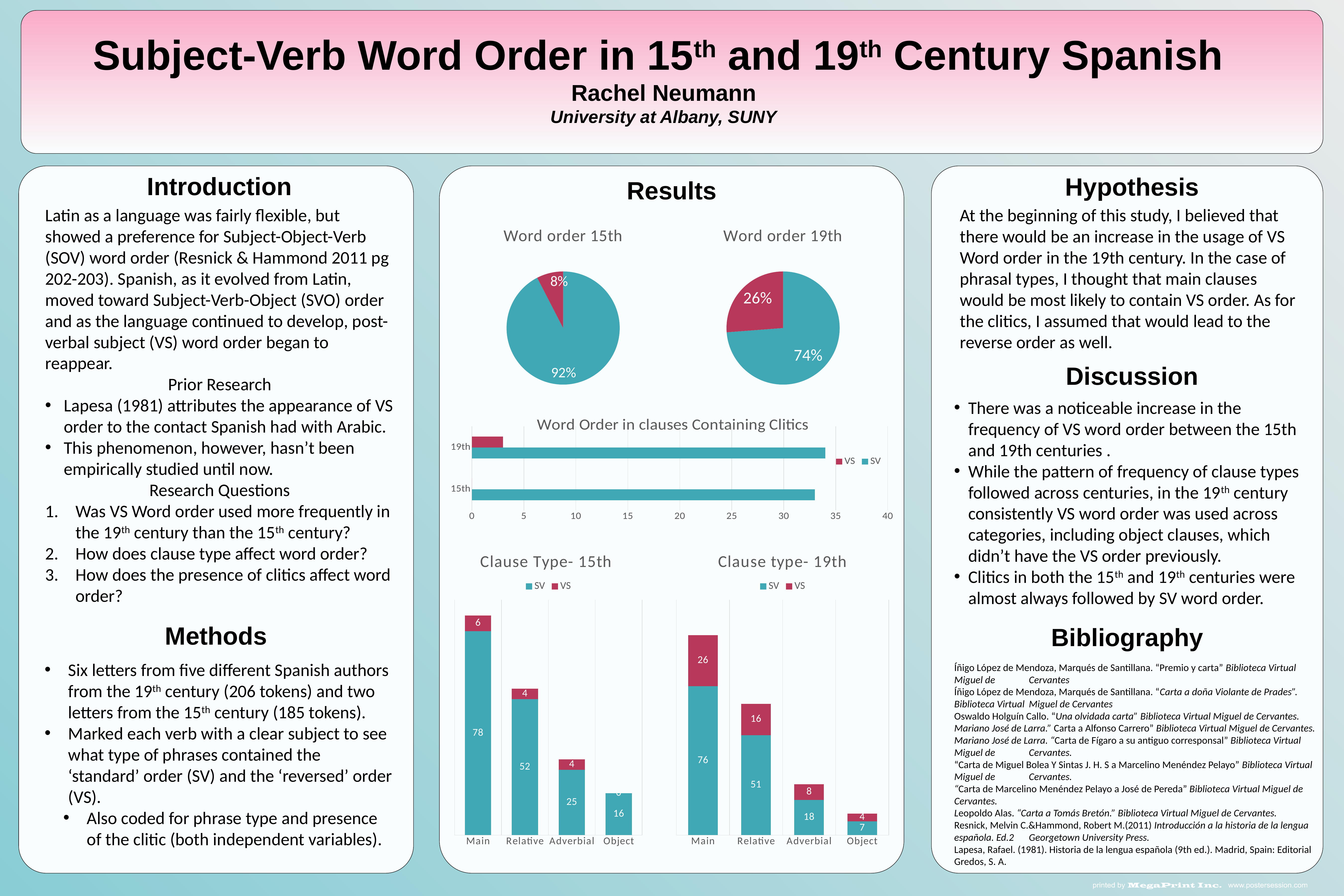
In the 'Clause Type- 15th' chart, what is the total of the stacked bar for Relative clauses? 56 In the 'Clause type- 19th' chart, which clause type has the lowest SV value? Object In the 'Word order 15th' pie chart, what share does the larger slice show? 92% In the 'Clause type- 19th' chart, what is the total of the stacked bar for Main clauses? 102 In the 'Clause type- 19th' chart, is the VS value for Adverbial clauses larger or smaller than the VS value for Object clauses? larger In the 'Clause Type- 15th' chart, what is the SV value for Main clauses? 78 In the 'Clause Type- 15th' chart, what is the difference between the SV values for Main and Adverbial clauses? 53 What kind of chart is 'Word Order in clauses Containing Clitics'? bar chart In the 'Word Order in clauses Containing Clitics' chart, is the SV value for 19th greater or less than 30? greater In the 'Word order 19th' pie chart, what share does the smaller slice show? 26% In the 'Word Order in clauses Containing Clitics' chart, is the VS value for 19th greater or less than 5? less In the 'Clause type- 19th' chart, what is the VS value for Relative clauses? 16